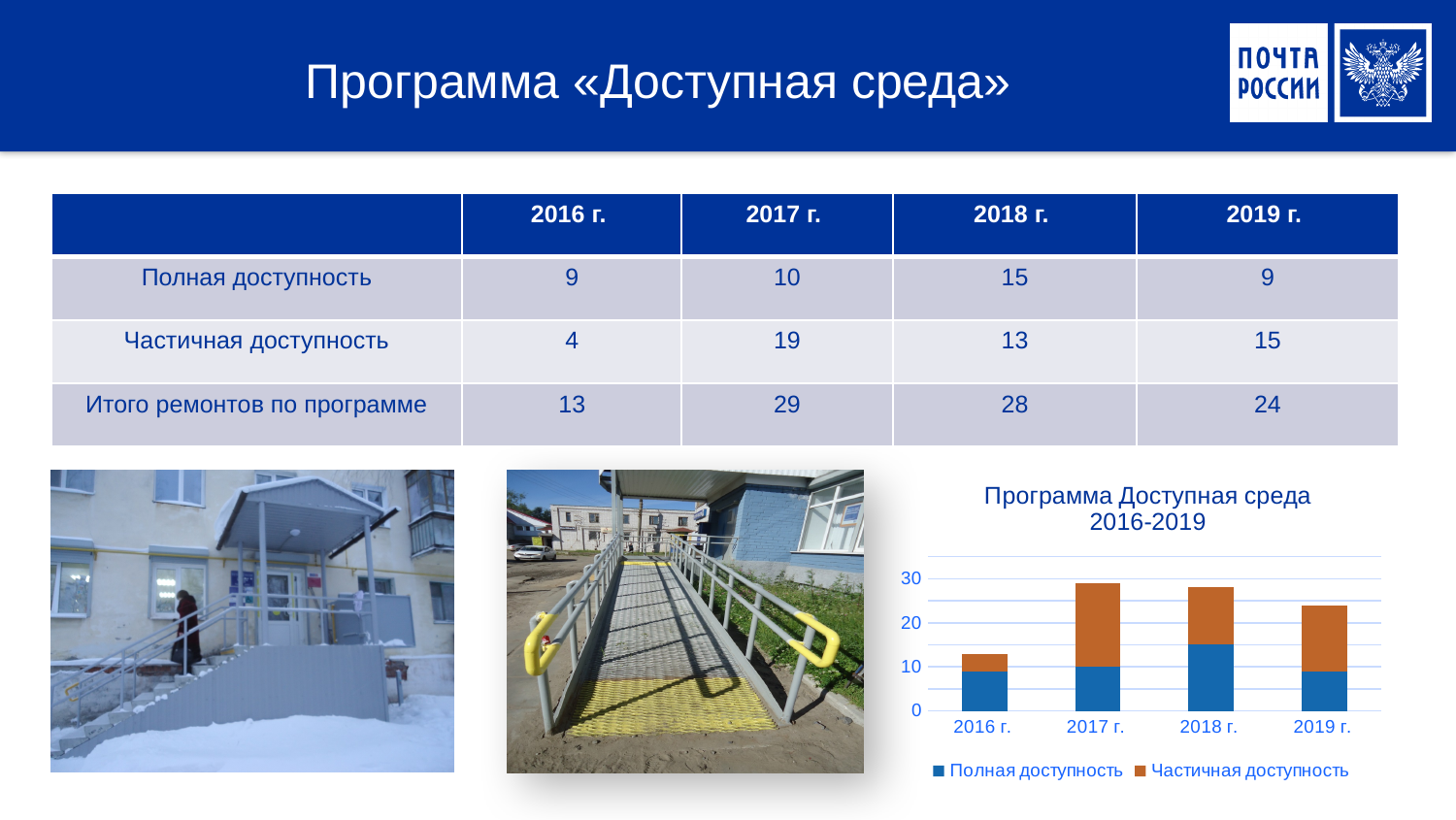
Is the total bar for 2017 г. greater or less than 20? greater According to the table, what is the difference between the total for 2017 г. and the total for 2016 г.? 16 How many years are shown on the x axis of the chart? 4 How many series does the chart legend list? 2 What is the title of the chart? Программа Доступная среда 2016-2019 According to the table, what is the Полная доступность value for 2018 г.? 15 Which year has the lowest total bar in the chart? 2016 г. Is the Полная доступность value for 2018 г. greater or less than 10? greater According to the table, what is the total of the stacked bar for 2019 г.? 24 What kind of chart is shown on the slide? stacked bar chart Which is larger in the chart: the Частичная доступность value for 2017 г. or for 2016 г.? 2017 г. Is the total bar for 2016 г. greater or less than 20? less